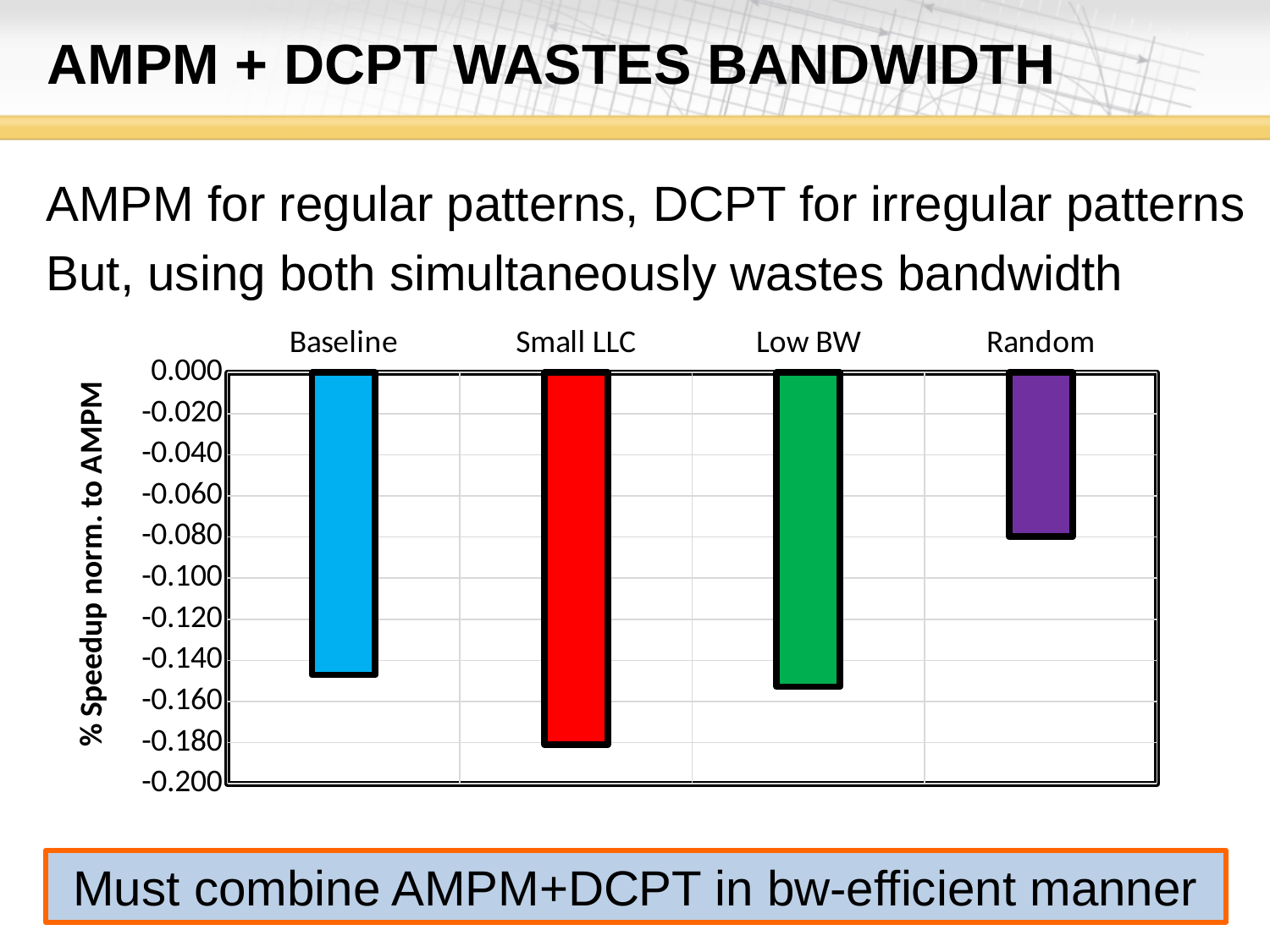
Is the value for Random greater or less than -0.100? greater What colour is the bar for Small LLC? red Which has the larger (less negative) value, Random or Low BW? Random Which category has the highest (least negative) value in the chart? Random What kind of chart is shown on the slide? bar chart What is the label of the vertical axis of the chart? % Speedup norm. to AMPM Which category has the lowest (most negative) value in the chart? Small LLC Is the value for Baseline greater or less than -0.120? less How many categories are plotted in the chart? 4 Is the value for Small LLC greater or less than -0.160? less Which has the larger (less negative) value, Baseline or Small LLC? Baseline